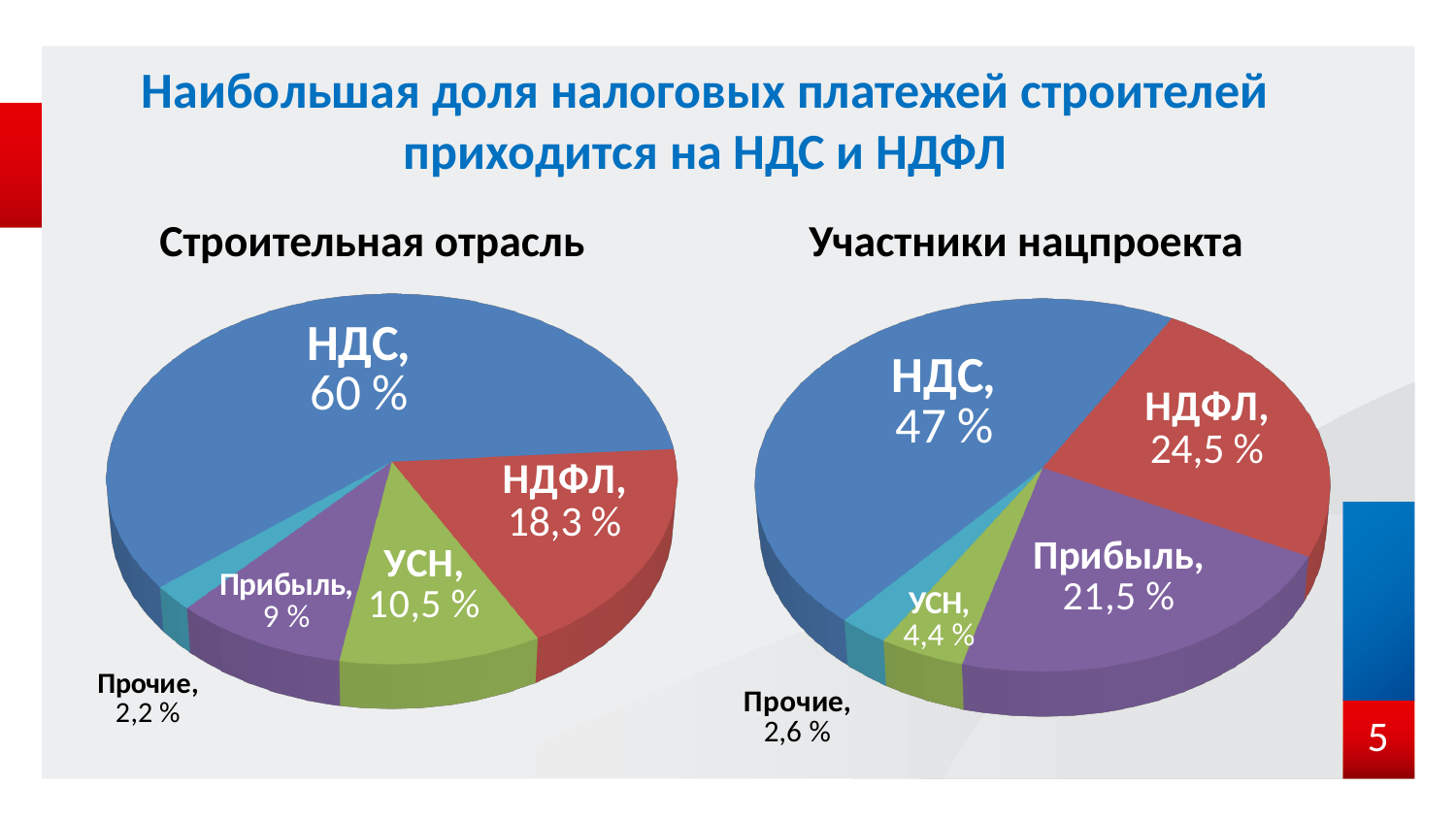
How many categories does the 'Участники нацпроекта' chart show? 5 In the 'Строительная отрасль' chart, which category has the largest share? НДС In the 'Строительная отрасль' chart, which is larger: УСН or Прибыль? УСН What kind of chart is the 'Строительная отрасль' chart? Pie chart In the 'Строительная отрасль' chart, what is the difference between the shares of НДС and НДФЛ? 41,7 % In the 'Строительная отрасль' chart, what share does НДС have? 60 % How many charts are on the slide? 2 In the 'Участники нацпроекта' chart, which category has the smallest share? Прочие In the 'Участники нацпроекта' chart, what is the difference between the shares of НДФЛ and Прибыль? 3 % In the 'Участники нацпроекта' chart, what is the value for Прочие? 2,6 % In the 'Строительная отрасль' chart, what is the value for УСН? 10,5 % In the 'Участники нацпроекта' chart, what share does НДФЛ have? 24,5 %